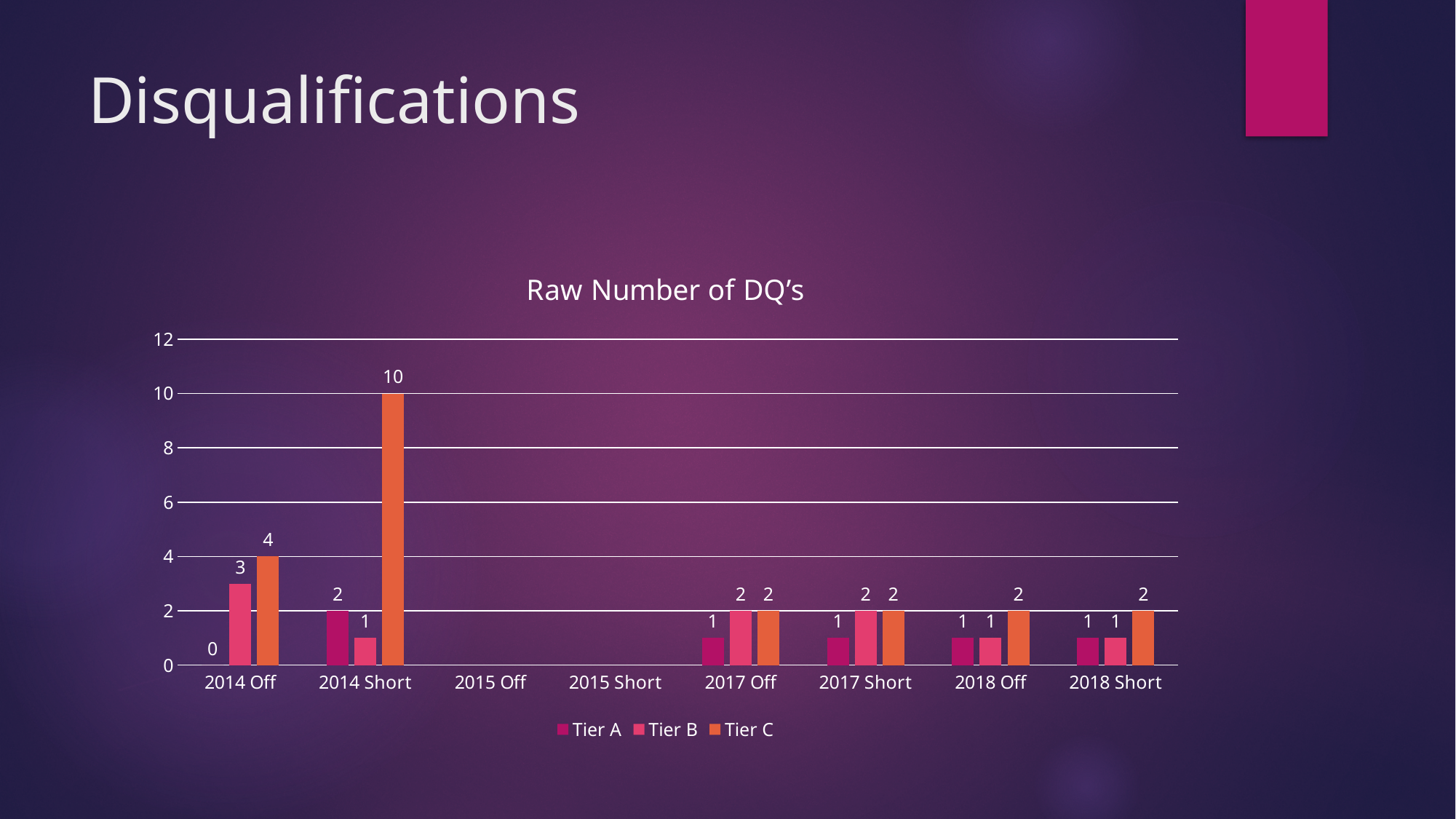
What is the title of the chart? Raw Number of DQ's How many categories are shown on the x axis? 8 What is the Tier C value for 2014 Short? 10 Which category has the highest Tier C value? 2014 Short Which series is shown in orange? Tier C Which is larger: the Tier A value for 2014 Short or the Tier B value for 2014 Short? Tier A What is the Tier C value for 2018 Off? 2 How many series does the legend list? 3 What is the Tier B value for 2014 Off? 3 What is the difference between the Tier C value for 2014 Short and the Tier C value for 2014 Off? 6 What kind of chart is shown on the slide? Bar chart What is the Tier A value for 2014 Off? 0